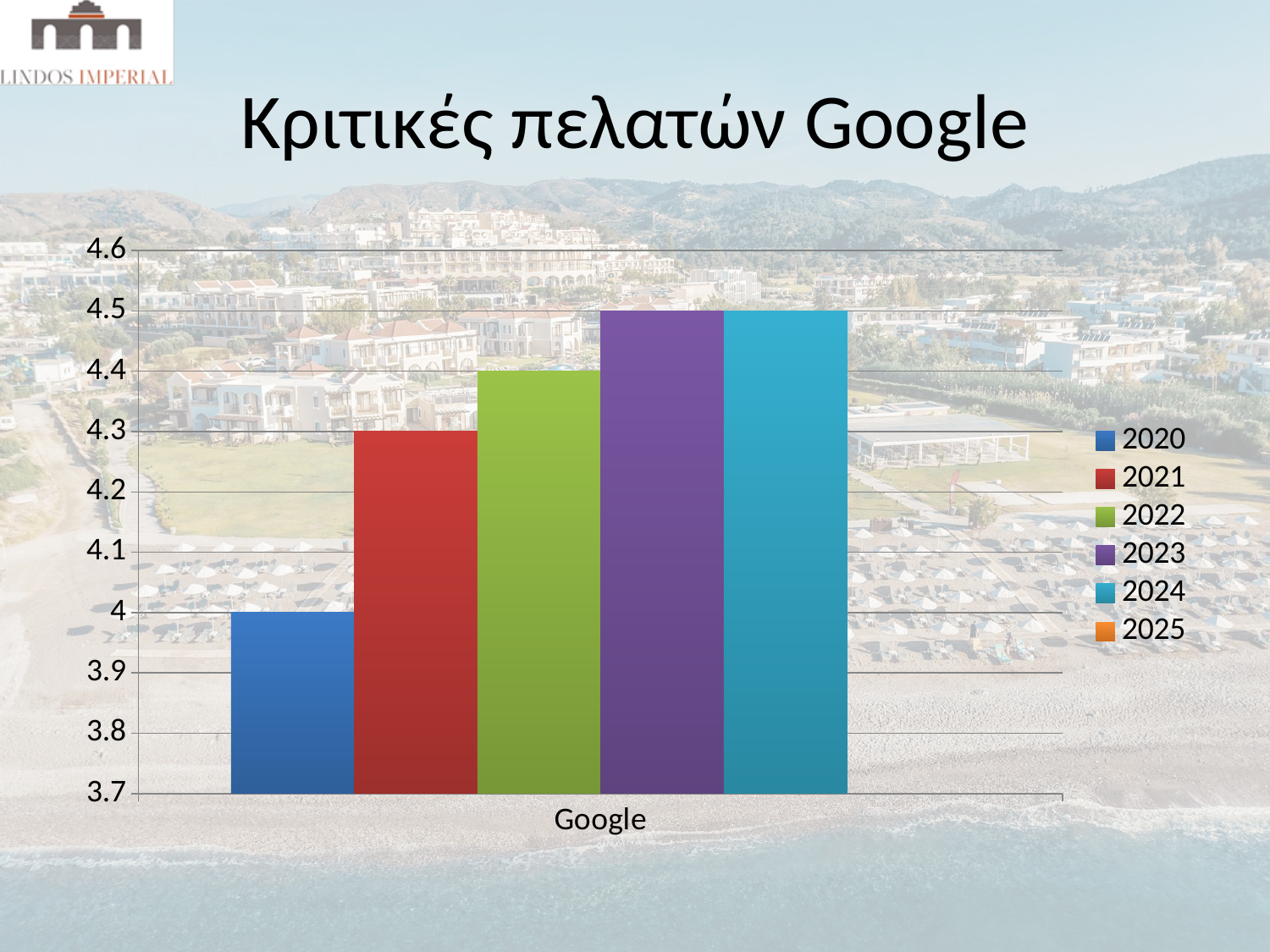
What is the value for 2021? 4.3 What is the value for 2020 in the Google reviews chart? 4 Which is larger, the value for 2022 or the value for 2021? 2022 What kind of chart is shown on the slide? bar chart Is the value for 2020 greater or less than 4.2? less What is the value for 2022? 4.4 How many series does the legend list? 6 What is the value for 2023? 4.5 Do the values rise or fall from 2020 to 2023? rise Which year has the lowest value? 2020 What is the difference between the values for 2021 and 2020? 0.3 What is the title of the chart? Κριτικές πελατών Google